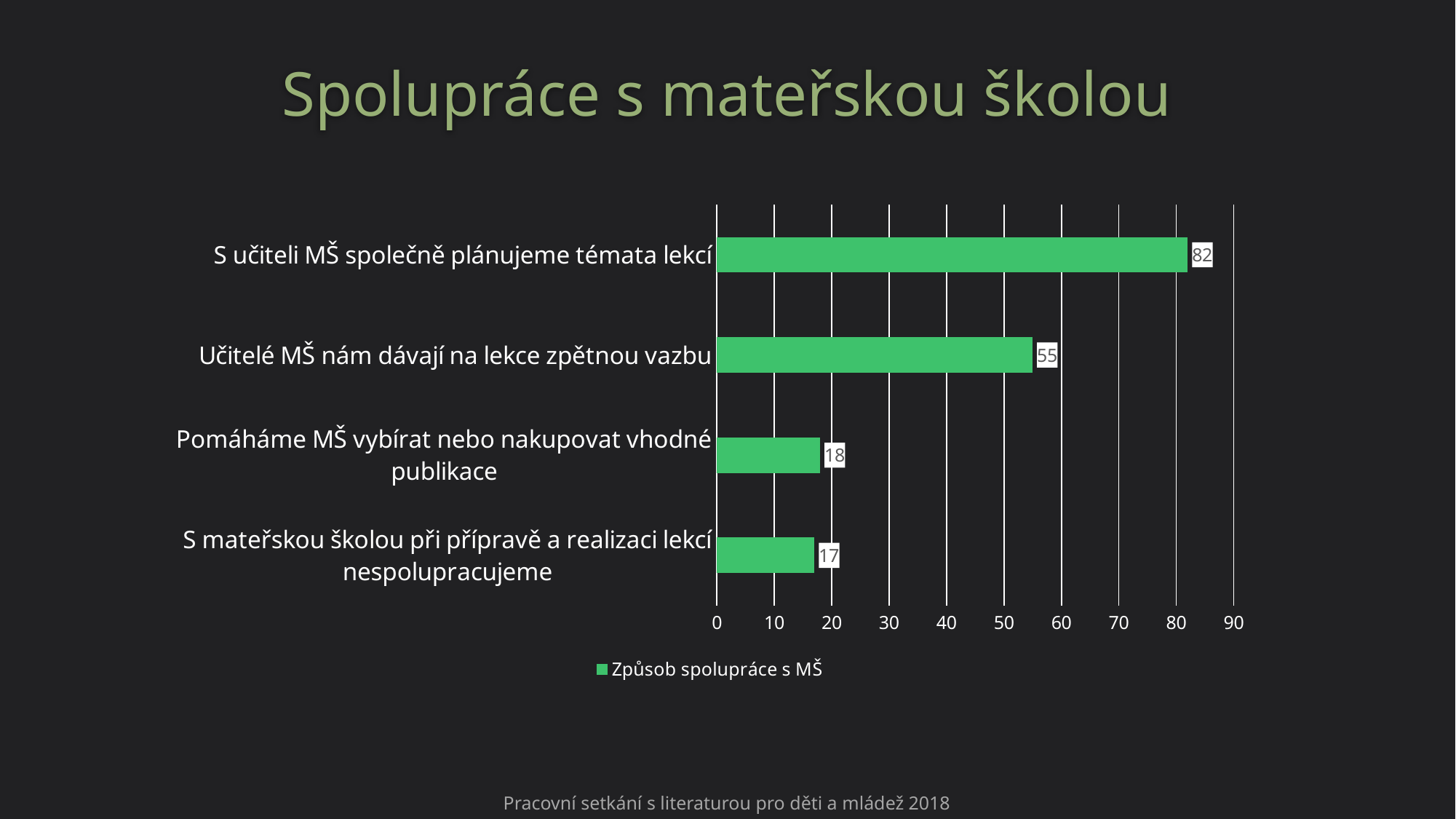
What is the value for "S učiteli MŠ společně plánujeme témata lekcí"? 82 What is the value for "Učitelé MŠ nám dávají na lekce zpětnou vazbu"? 55 What kind of chart is shown on the slide? bar chart Which is larger: the value for "Učitelé MŠ nám dávají na lekce zpětnou vazbu" or the value for "Pomáháme MŠ vybírat nebo nakupovat vhodné publikace"? Učitelé MŠ nám dávají na lekce zpětnou vazbu What is the value for "Pomáháme MŠ vybírat nebo nakupovat vhodné publikace"? 18 What is the value for "S mateřskou školou při přípravě a realizaci lekcí nespolupracujeme"? 17 Which category has the highest value? S učiteli MŠ společně plánujeme témata lekcí Is the value for "Učitelé MŠ nám dávají na lekce zpětnou vazbu" greater or less than 50? greater How many categories are shown in the chart? 4 What is the legend entry of the chart? Způsob spolupráce s MŠ Which category has the lowest value? S mateřskou školou při přípravě a realizaci lekcí nespolupracujeme What is the difference between the values for "S učiteli MŠ společně plánujeme témata lekcí" and "Učitelé MŠ nám dávají na lekce zpětnou vazbu"? 27